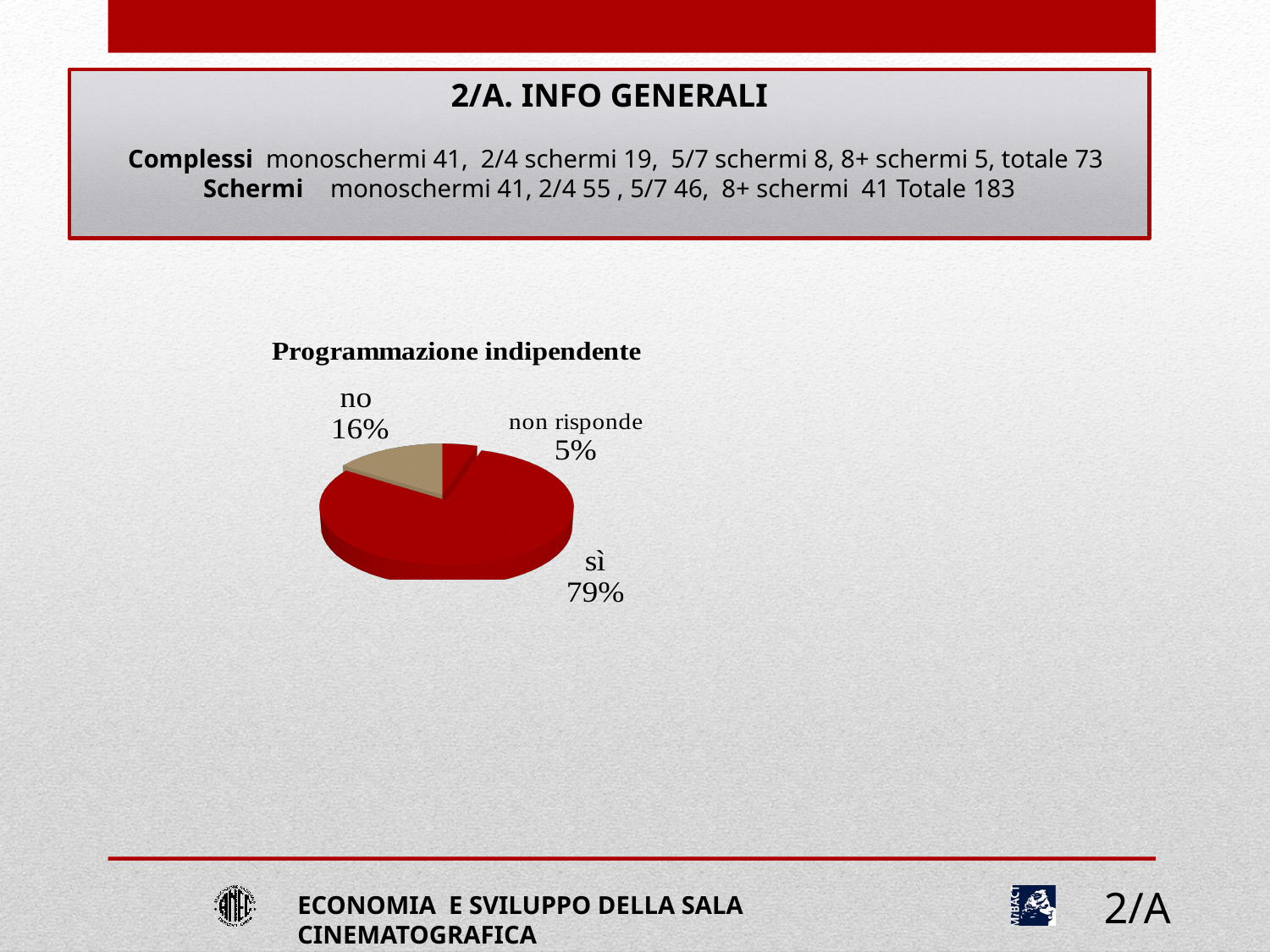
Which is larger, the "no" slice or the "non risponde" slice? no What share of the pie does the "non risponde" slice represent? 5% What colour is the "no" slice of the pie? tan (beige) What share of the pie does the "no" slice represent? 16% How many slices does the pie chart have? 3 What is the title of the chart? Programmazione indipendente Which slice of the pie is the largest? sì What is the difference in percentage points between the "no" slice and the "non risponde" slice? 11 What is the difference in percentage points between the "sì" slice and the "no" slice? 63 What share of the pie does the "sì" slice represent? 79% Which slice of the pie is the smallest? non risponde What kind of chart is shown on the slide? pie chart